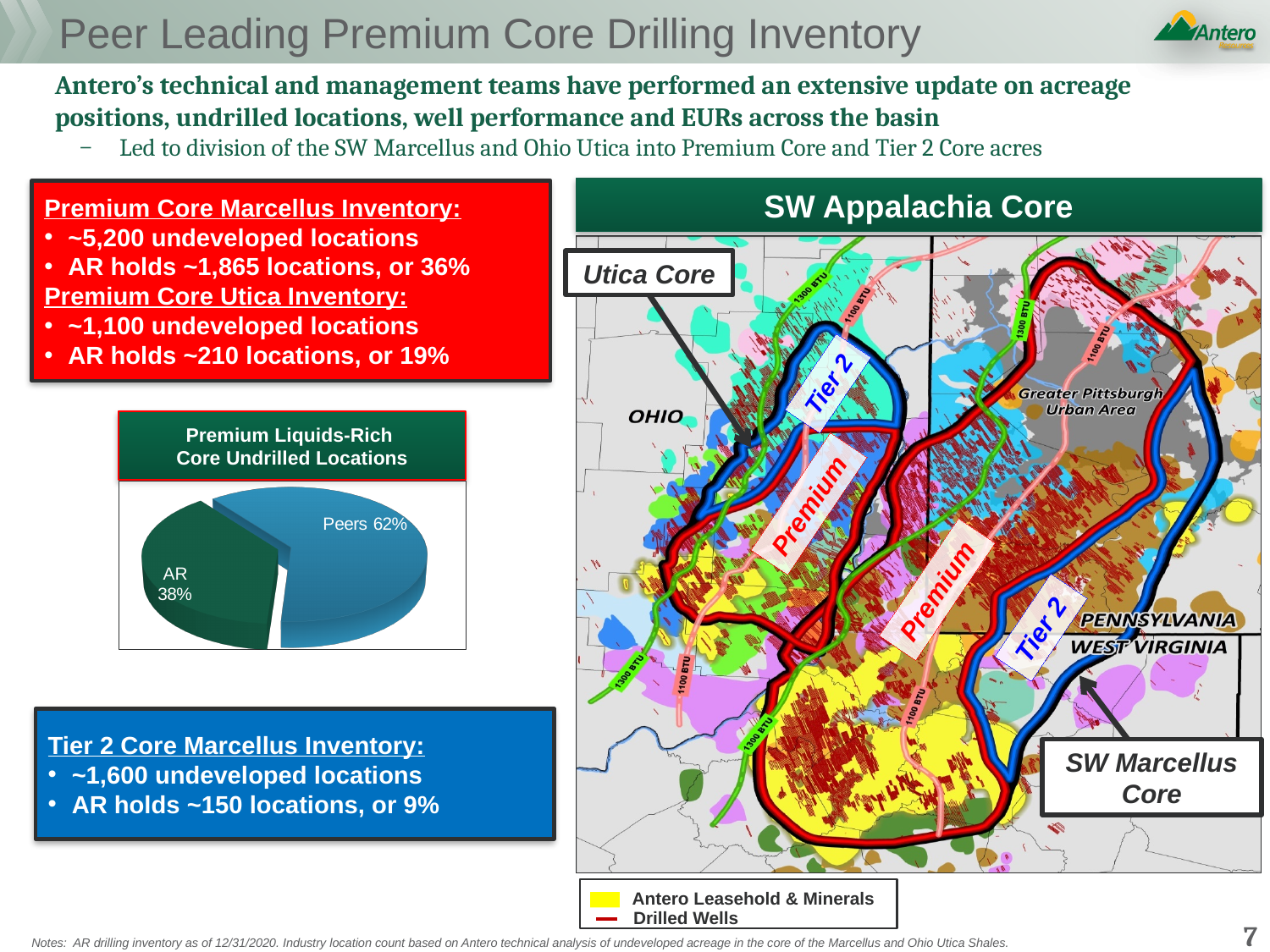
In the "Premium Liquids-Rich Core Undrilled Locations" pie chart, which is larger, the AR slice or the Peers slice? Peers In the "Premium Liquids-Rich Core Undrilled Locations" pie chart, what share is labelled for AR? 38% In the "Premium Liquids-Rich Core Undrilled Locations" pie chart, what is the difference in percentage points between the Peers share and the AR share? 24 percentage points In the "Premium Liquids-Rich Core Undrilled Locations" pie chart, is the AR share greater or less than 50%? less What is the title of the pie chart on the slide? Premium Liquids-Rich Core Undrilled Locations In the "Premium Liquids-Rich Core Undrilled Locations" pie chart, what colour is the AR slice? dark green In the "Premium Liquids-Rich Core Undrilled Locations" pie chart, what share is labelled for Peers? 62% In the "Premium Liquids-Rich Core Undrilled Locations" pie chart, which slice is the largest? Peers How many slices does the "Premium Liquids-Rich Core Undrilled Locations" pie chart have? 2 What kind of chart is shown under the title "Premium Liquids-Rich Core Undrilled Locations"? pie chart In the "Premium Liquids-Rich Core Undrilled Locations" pie chart, which slice is the smallest? AR